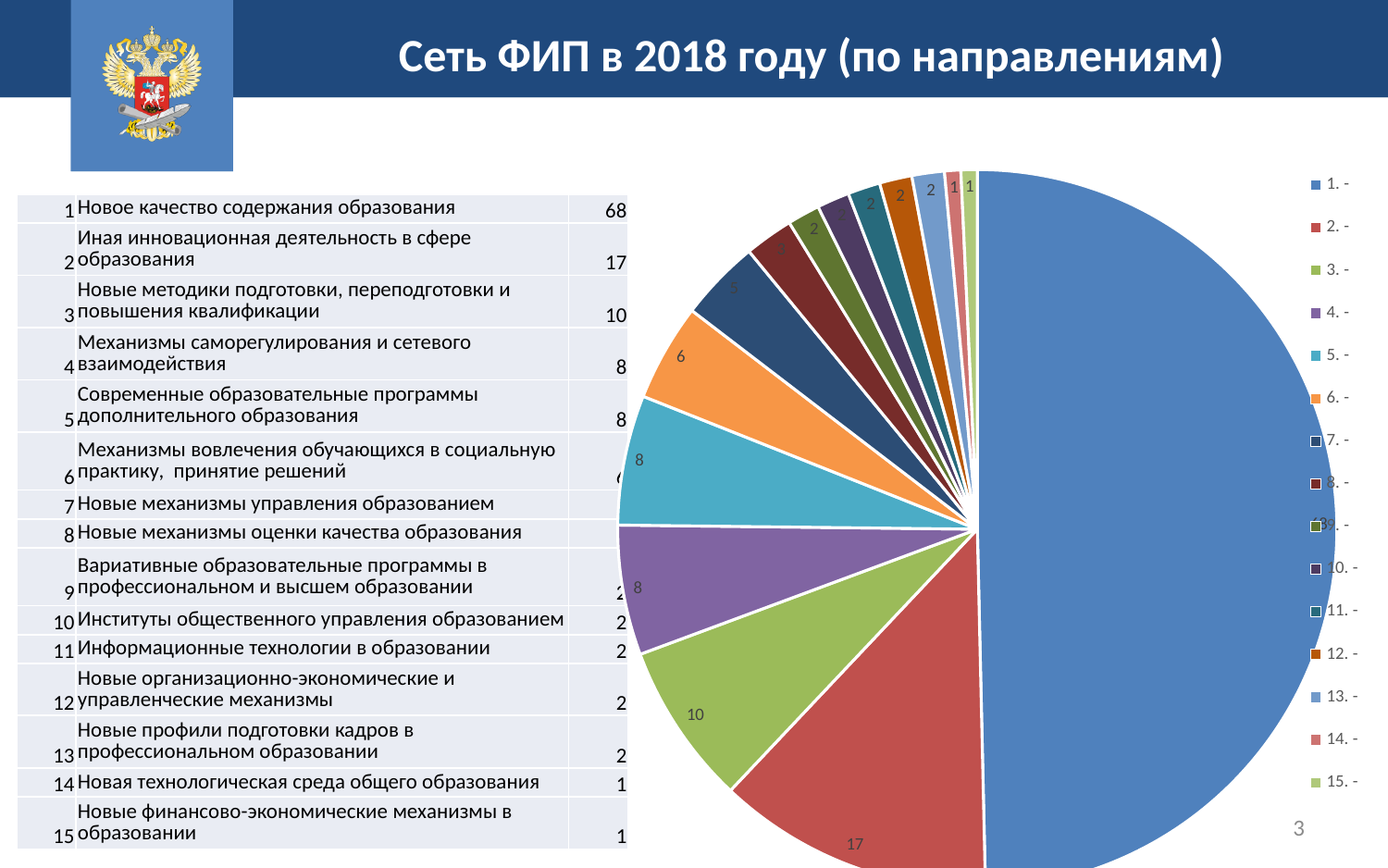
How many slices does the pie chart have? 15 What is the value of the red slice (category 2) in the pie chart? 17 What is the value of the orange slice labelled for category 6 in the pie chart? 6 Which category has the largest slice in the pie chart? 1 How many entries does the legend of the pie chart list? 15 What value is shown for category 14 (Новая технологическая среда общего образования)? 1 What is the difference between the values of category 3 and category 4 in the pie chart? 2 What is the difference between the values of category 2 and category 3 in the pie chart? 7 What is the title of the slide containing the pie chart? Сеть ФИП в 2018 году (по направлениям) What kind of chart is shown on the slide? pie chart Which slice is larger in the pie chart, category 2 or category 3? category 2 What is the value of the green slice (category 3) in the pie chart? 10